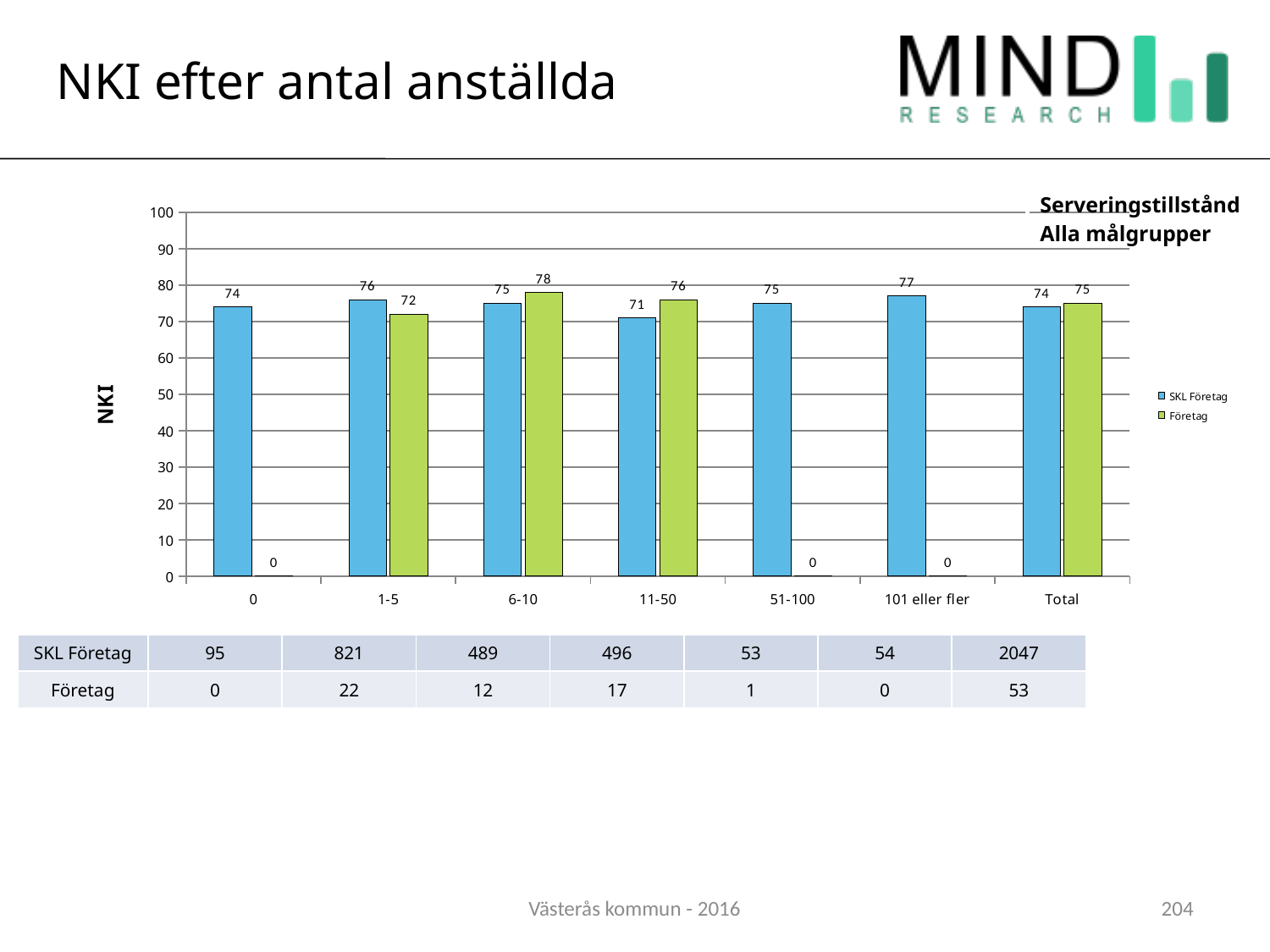
Which series is shown in green in the chart? Företag Which category has the lowest NKI value for SKL Företag? 11-50 What is the NKI value for Företag in the Total category? 75 How many series does the chart legend list? 2 How many categories are shown on the x axis of the chart? 7 Which category has the highest NKI value for SKL Företag? 101 eller fler What is the difference between the Företag and SKL Företag NKI values in the 11-50 category? 5 What kind of chart is shown on the slide? Bar chart What is the NKI value for SKL Företag in the 11-50 category? 71 In the 1-5 category, which series has the higher NKI value, SKL Företag or Företag? SKL Företag What is the NKI value for Företag in the 6-10 category? 78 What is the label of the vertical axis of the chart? NKI